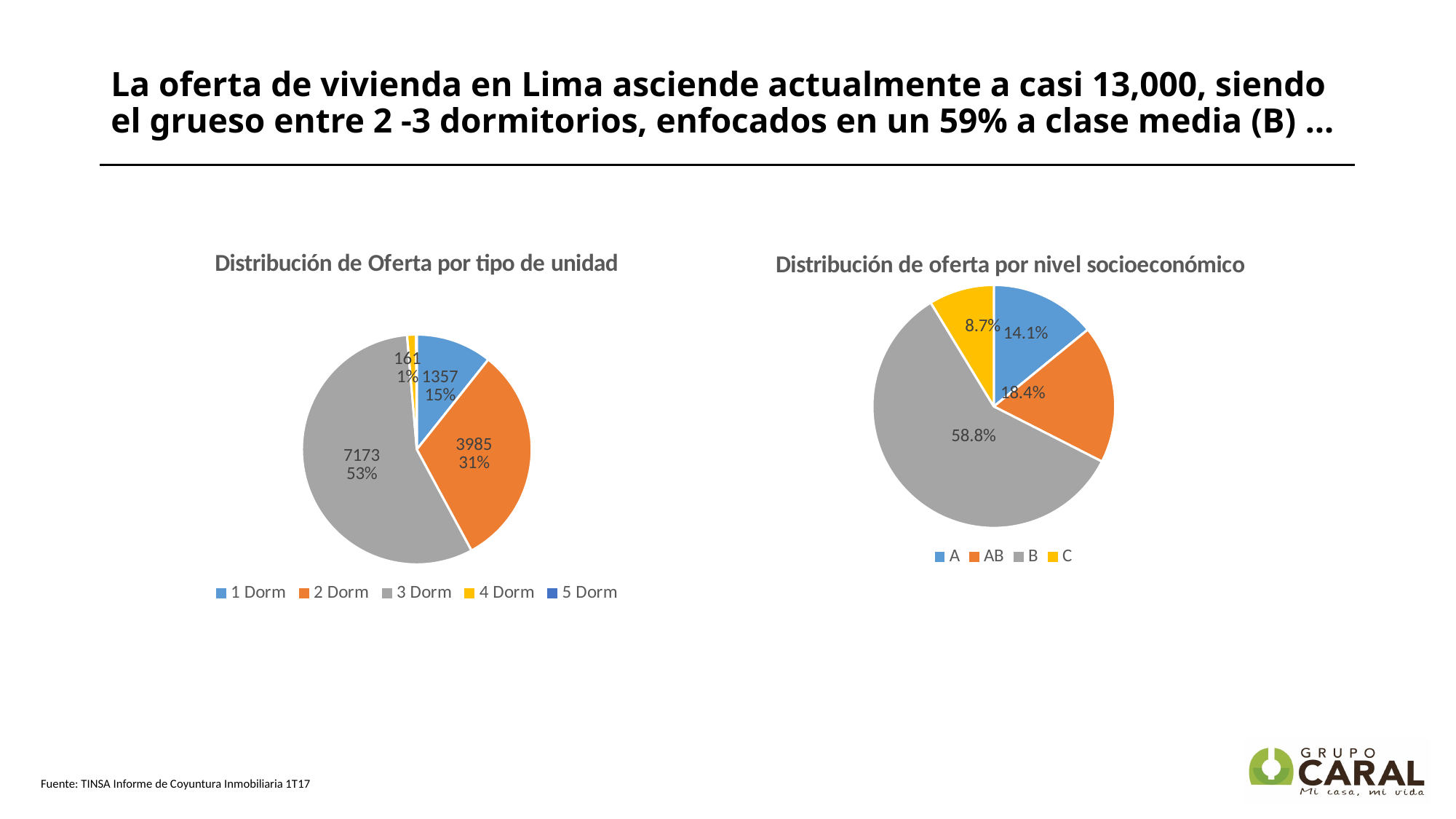
In the chart 'Distribución de oferta por nivel socioeconómico', what is the share for B? 58.8% What type of chart is 'Distribución de oferta por nivel socioeconómico'? Pie chart In the chart 'Distribución de Oferta por tipo de unidad', what is the value for 3 Dorm? 7173 In the chart 'Distribución de Oferta por tipo de unidad', what percentage share does 2 Dorm have? 31% In the chart 'Distribución de oferta por nivel socioeconómico', what is the share for C? 8.7% In the chart 'Distribución de oferta por nivel socioeconómico', what is the difference between the shares of AB and A? 4.3% In the chart 'Distribución de oferta por nivel socioeconómico', which category has the smallest slice? C In the chart 'Distribución de Oferta por tipo de unidad', what is the difference between the values for 3 Dorm and 2 Dorm? 3188 In the chart 'Distribución de Oferta por tipo de unidad', how many entries does the legend list? 5 In the chart 'Distribución de Oferta por tipo de unidad', which category has the largest slice? 3 Dorm In the chart 'Distribución de oferta por nivel socioeconómico', which is larger, A or AB? AB In the chart 'Distribución de Oferta por tipo de unidad', what is the value for 1 Dorm? 1357